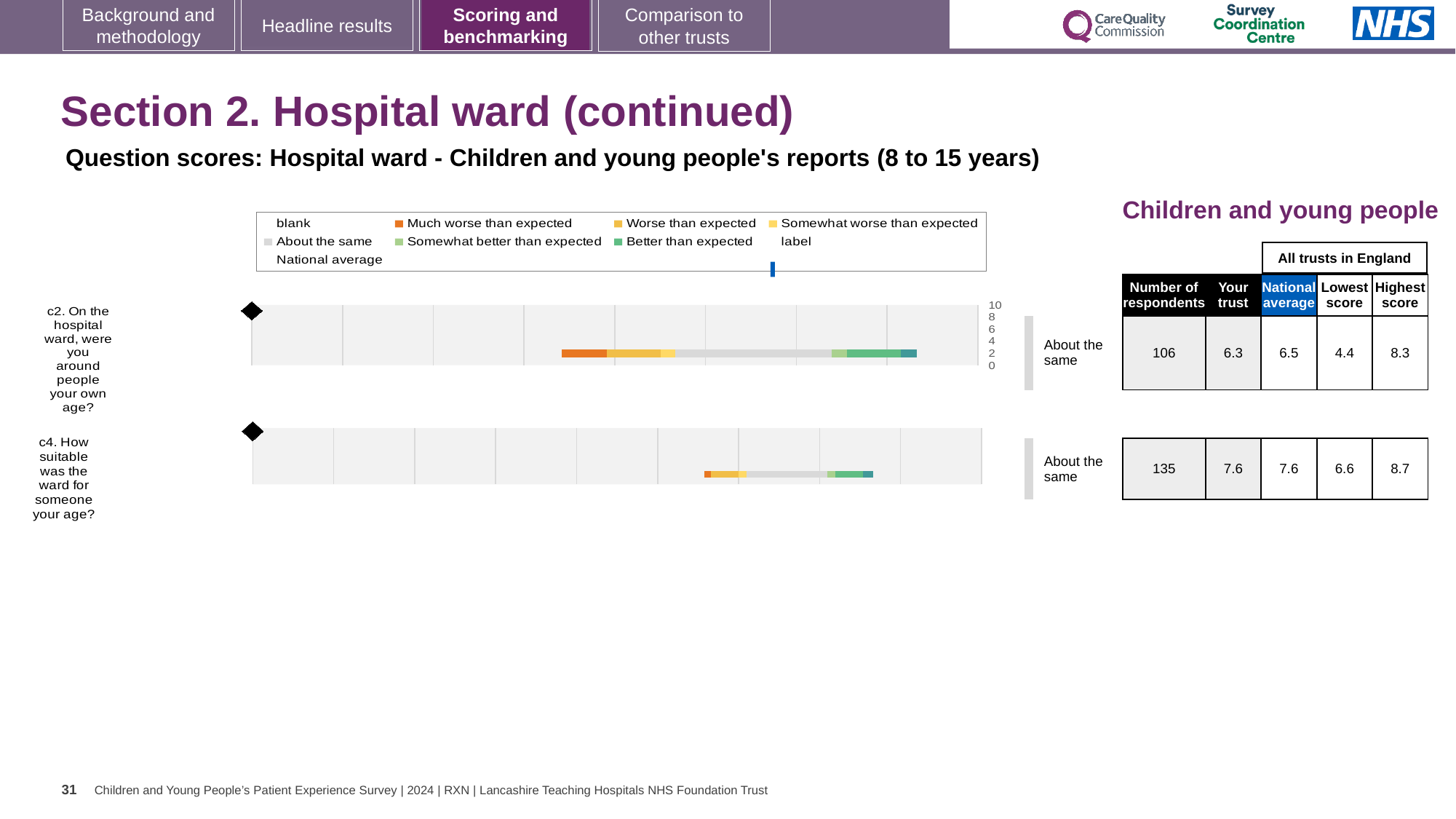
What is the difference between the highest and lowest scores for c2? 3.9 What is the national average score for c4 (How suitable was the ward for someone your age?)? 7.6 What benchmark category is shown for c2? About the same What is the lowest score across all trusts in England for c4? 6.6 What kind of chart is used to show the question scores for c2 and c4? bar chart How many respondents answered question c2? 106 How many questions are plotted on the slide? 2 How much higher is the trust's score for c4 than for c2? 1.3 What is the 'Your trust' score for c2 (On the hospital ward, were you around people your own age?)? 6.3 Which colour in the legend represents 'Much worse than expected'? orange Which question has the higher 'Your trust' score, c2 or c4? c4 How many more respondents answered c4 than c2? 29